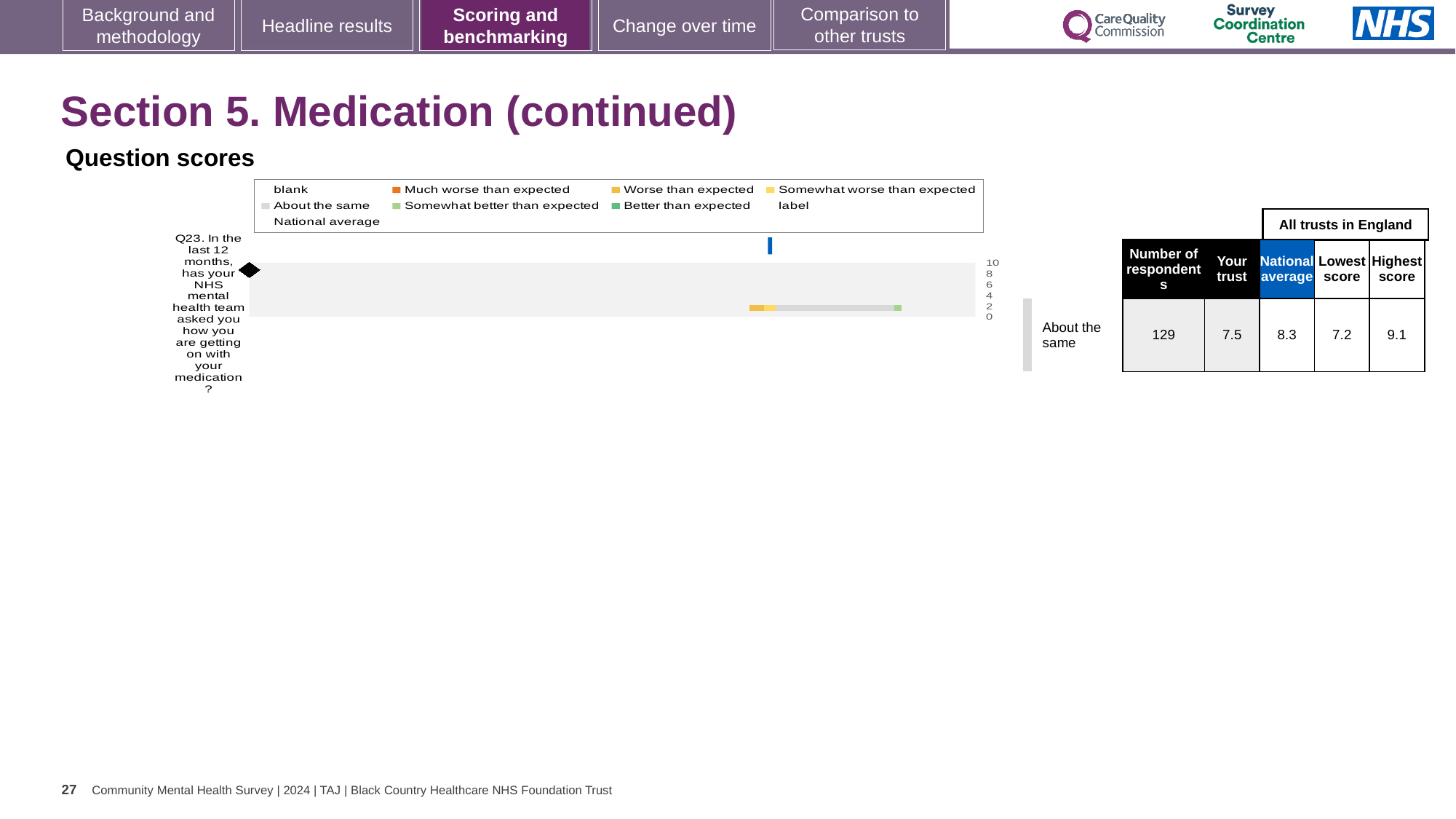
How many respondents answered Q23? 129 What is the highest value shown on the chart's score axis? 10 Which question is plotted on the chart? Q23. In the last 12 months, has your NHS mental health team asked you how you are getting on with your medication? Which is larger for Q23, the 'Your trust' score or the national average? National average What kind of chart is used to show the Q23 question score? bar chart What is the difference between the highest score and the lowest score for Q23? 1.9 What is the highest score among all trusts in England for Q23? 9.1 What benchmark category label is shown for Q23 to the right of the chart? About the same How many survey questions are plotted on the chart? 1 What is the 'Your trust' score for Q23 shown next to the chart? 7.5 What is the lowest score among all trusts in England for Q23? 7.2 What is the national average score for Q23 shown next to the chart? 8.3